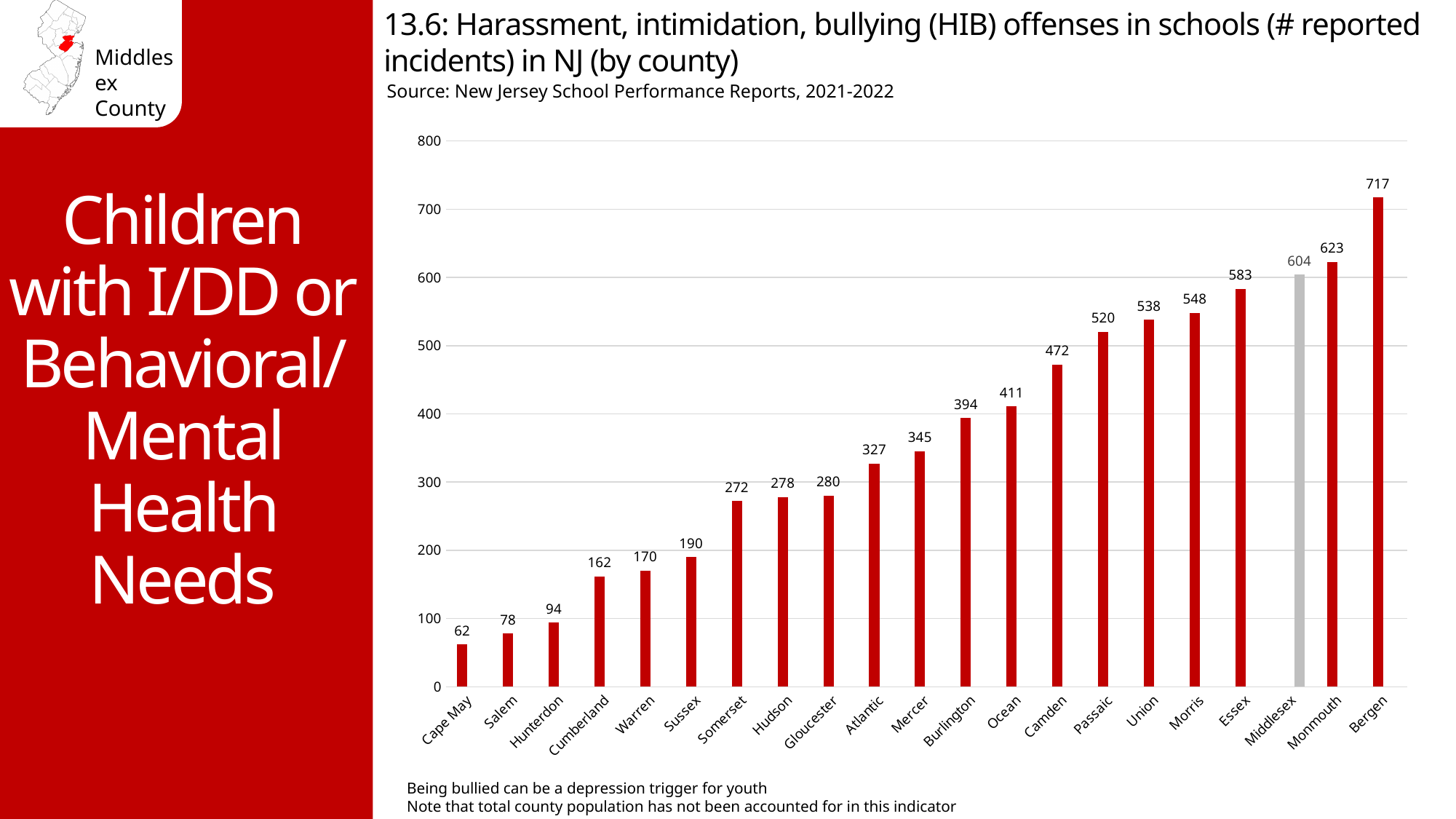
What kind of chart is used to show the HIB incidents by county? bar chart What is the number of reported HIB incidents for Hudson county? 278 Do the values rise or fall moving from left to right along the x axis? rise How many counties are shown on the chart? 21 Which county has the lowest number of reported HIB incidents? Cape May What is the difference in reported HIB incidents between Bergen and Middlesex? 113 Which county's bar is shown in grey instead of red? Middlesex What is the number of reported HIB incidents for Middlesex county? 604 Which county has more reported HIB incidents, Camden or Passaic? Passaic What is the source cited for the chart data? New Jersey School Performance Reports, 2021-2022 Which county has the highest number of reported HIB incidents? Bergen Is the value for Essex greater or less than 600? less